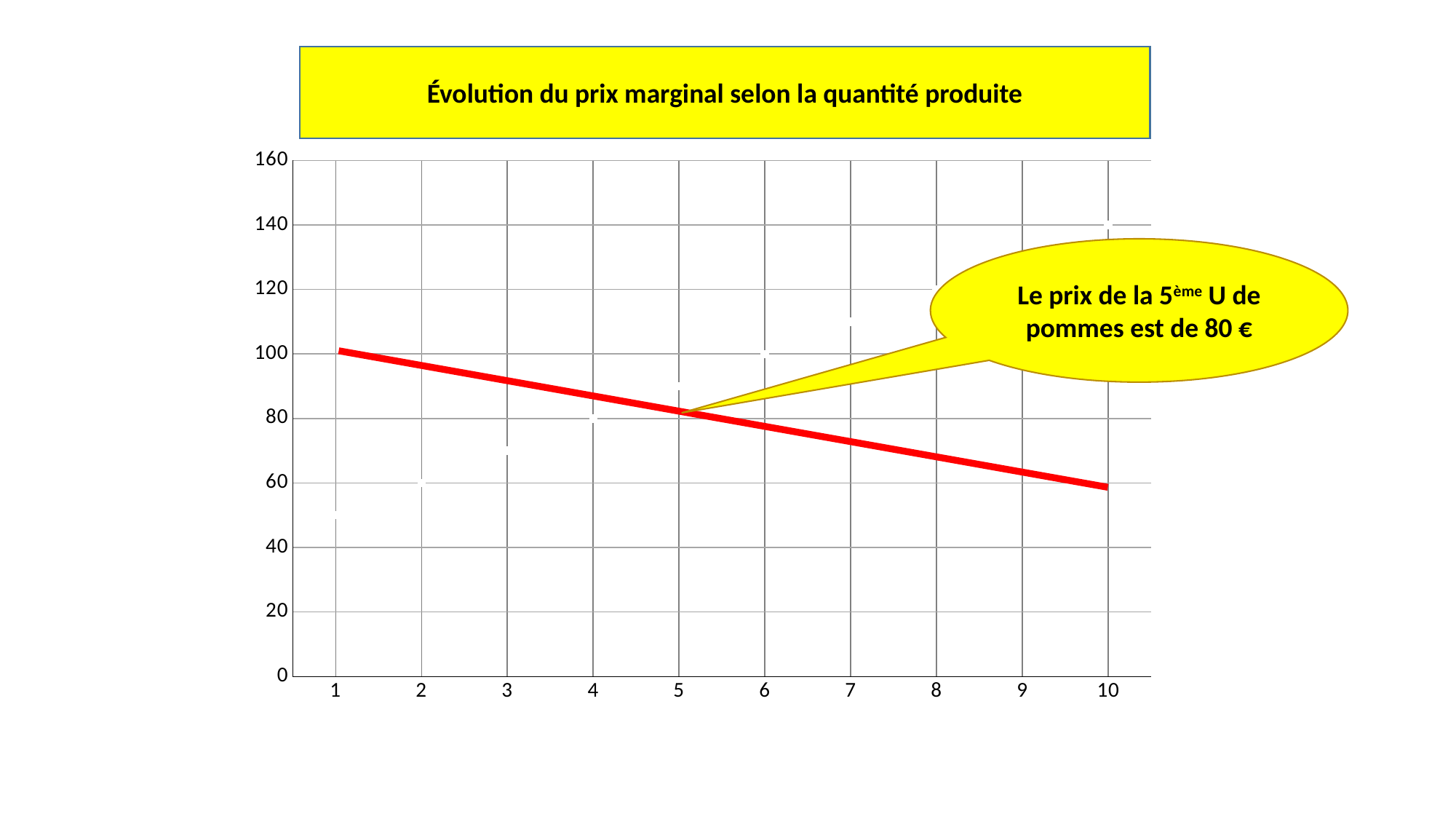
Is the value at quantity 8 greater or less than 80? less What kind of chart is shown on the slide? line chart What colour is the plotted line? red Which has the larger marginal price, quantity 2 or quantity 9? quantity 2 At which quantity is the marginal price lowest? 10 At which quantity is the marginal price highest? 1 Do the values rise or fall as the quantity increases along the x axis? fall According to the callout, what is the marginal price of the 5th unit? 80 € How many quantity points are shown on the x axis? 10 Is the value at quantity 1 greater or less than 80? greater What is the title of the chart? Évolution du prix marginal selon la quantité produite Is the value at quantity 10 greater or less than 80? less